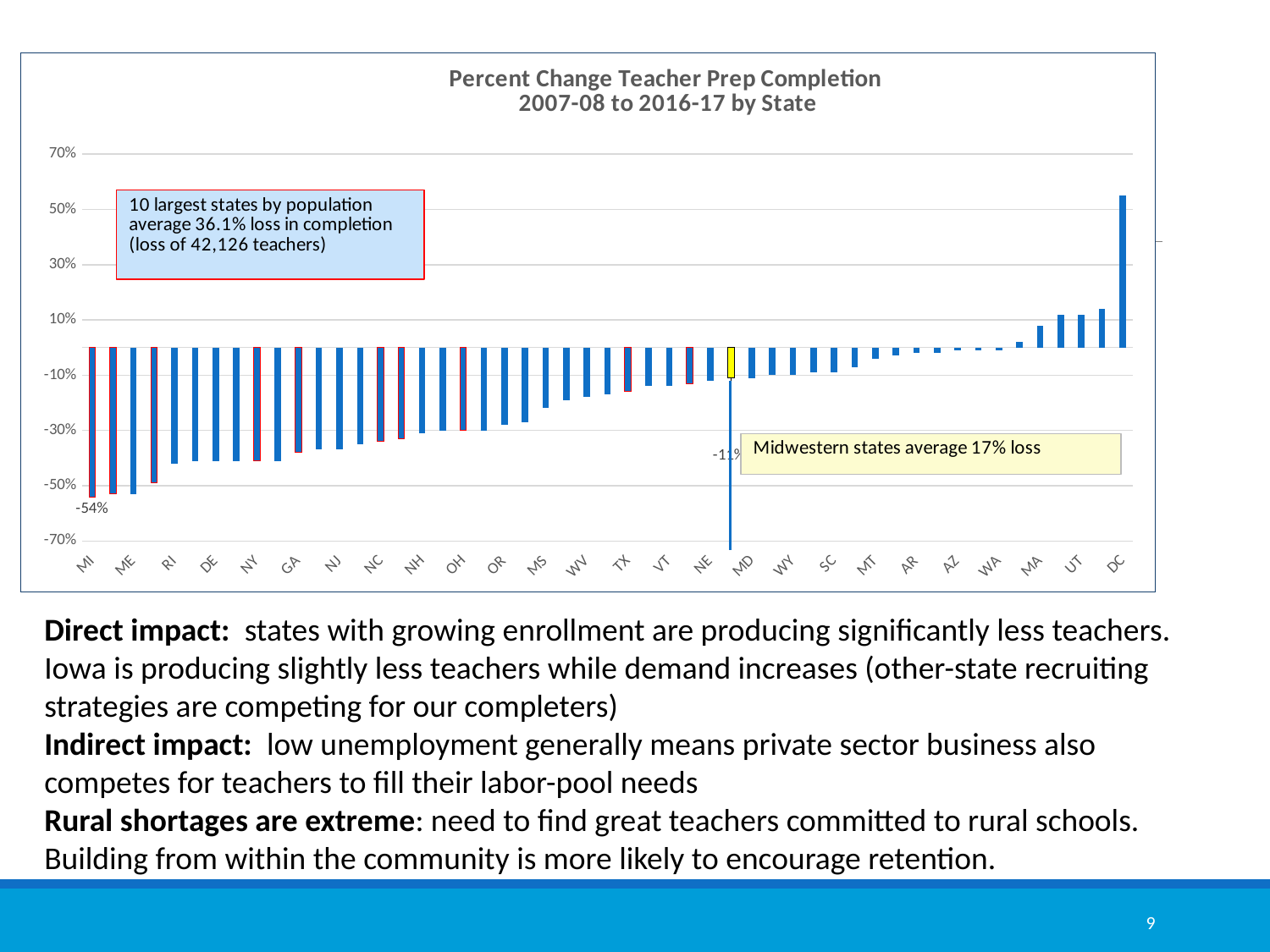
Is the value for OH greater or less than -10%? less Is the value for TX greater or less than -10%? less Which state has the highest percent change in teacher prep completion? DC Is the value for DC greater or less than 50%? greater What is the percent change in teacher prep completion for MI? -54% According to the text box on the chart, what is the average loss in completion for the 10 largest states by population? 36.1% What is the title of the chart? Percent Change Teacher Prep Completion 2007-08 to 2016-17 by State Which has the larger percent change, NY or TX? TX What kind of chart is shown on the slide? Bar chart Which has the larger percent change, MI or DC? DC Do the values generally rise or fall moving from left to right along the x axis? Rise